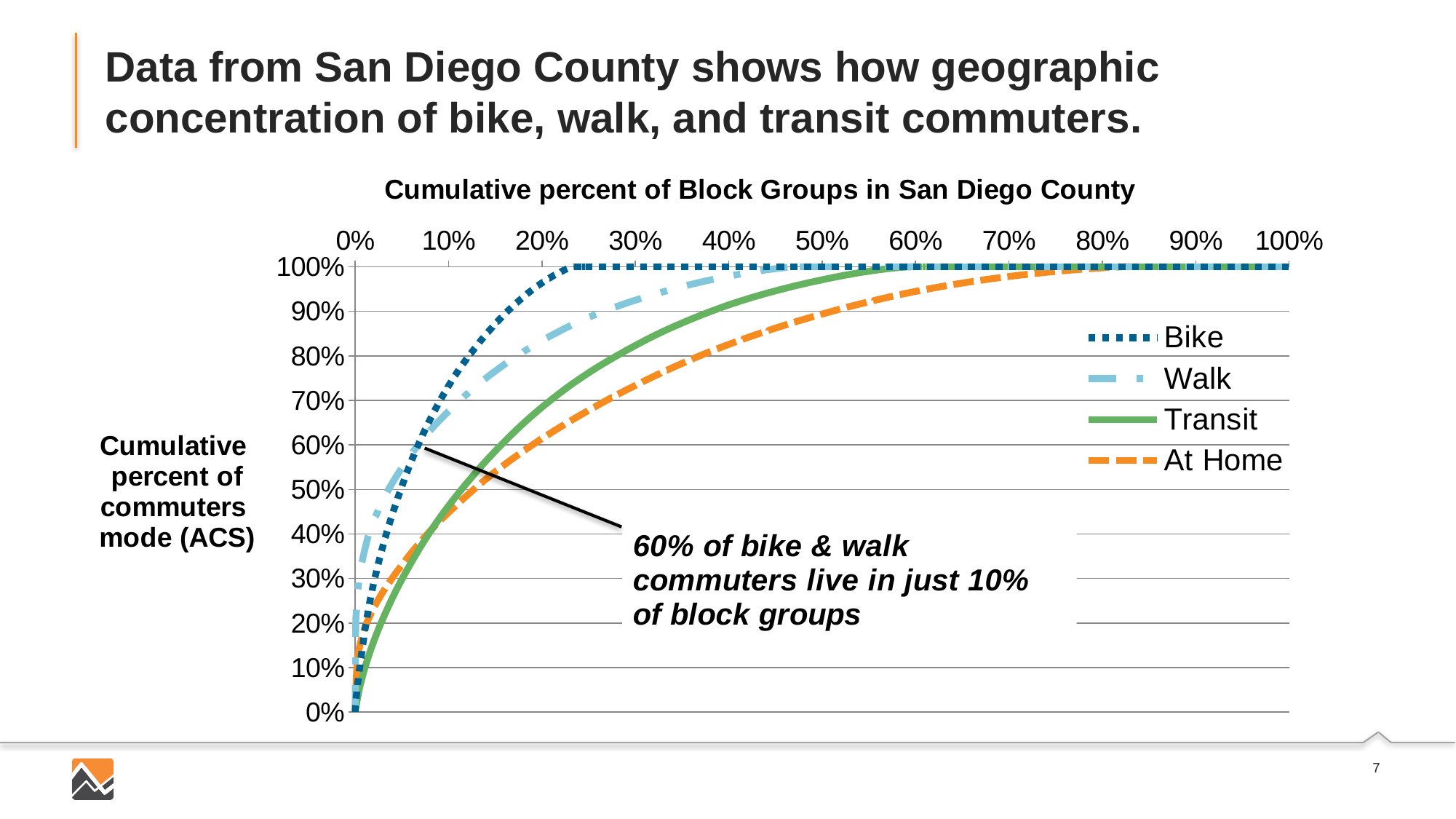
At 30% of block groups, which series has the higher value, Walk or At Home? Walk Is the value for Bike at 20% of block groups greater or less than 90%? greater What is the title of the chart? Cumulative percent of Block Groups in San Diego County Is the value for At Home at 50% of block groups greater or less than 80%? greater What are the four series named in the legend? Bike, Walk, Transit, At Home Do the values for the Transit series rise or fall as the cumulative percent of block groups increases? rise At 40% of block groups, which series has the lowest value? At Home At 10% of block groups, which series has the higher value, Bike or Transit? Bike What kind of chart is shown on the slide? line chart Is the value for Transit at 50% of block groups greater or less than 90%? greater How many series does the legend list? 4